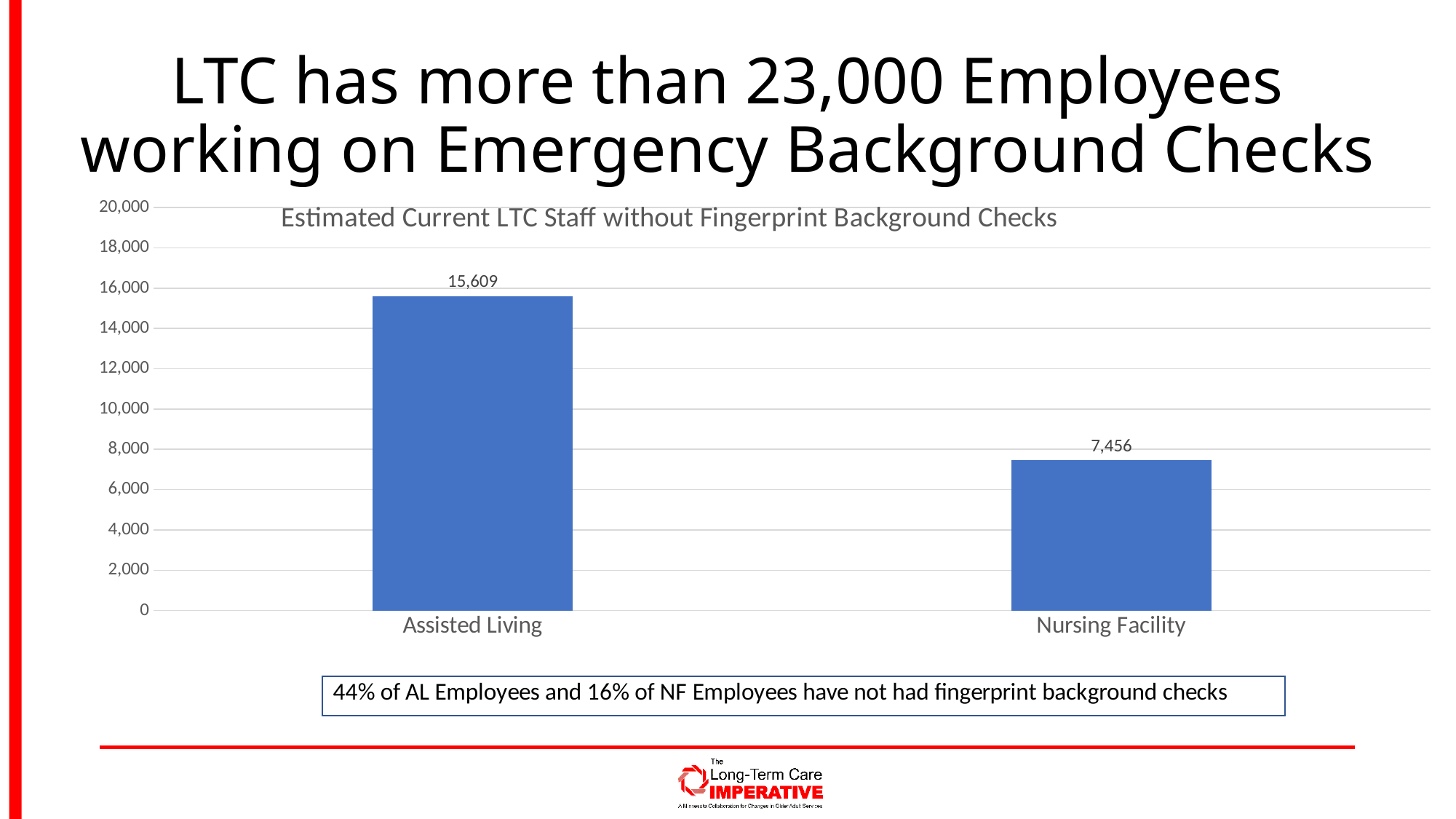
Which is larger, the value for Assisted Living or the value for Nursing Facility? Assisted Living What is the value for Assisted Living? 15,609 Which category has the lowest value? Nursing Facility How many categories are shown in the chart? 2 Is the value for Assisted Living greater or less than 14,000? greater What is the highest value shown on the vertical axis? 20,000 What kind of chart is shown on the slide? Bar chart What is the value for Nursing Facility? 7,456 What is the difference between the Assisted Living and Nursing Facility values? 8,153 Is the value for Nursing Facility greater or less than 8,000? less Which category has the highest value? Assisted Living What is the title of the chart? Estimated Current LTC Staff without Fingerprint Background Checks